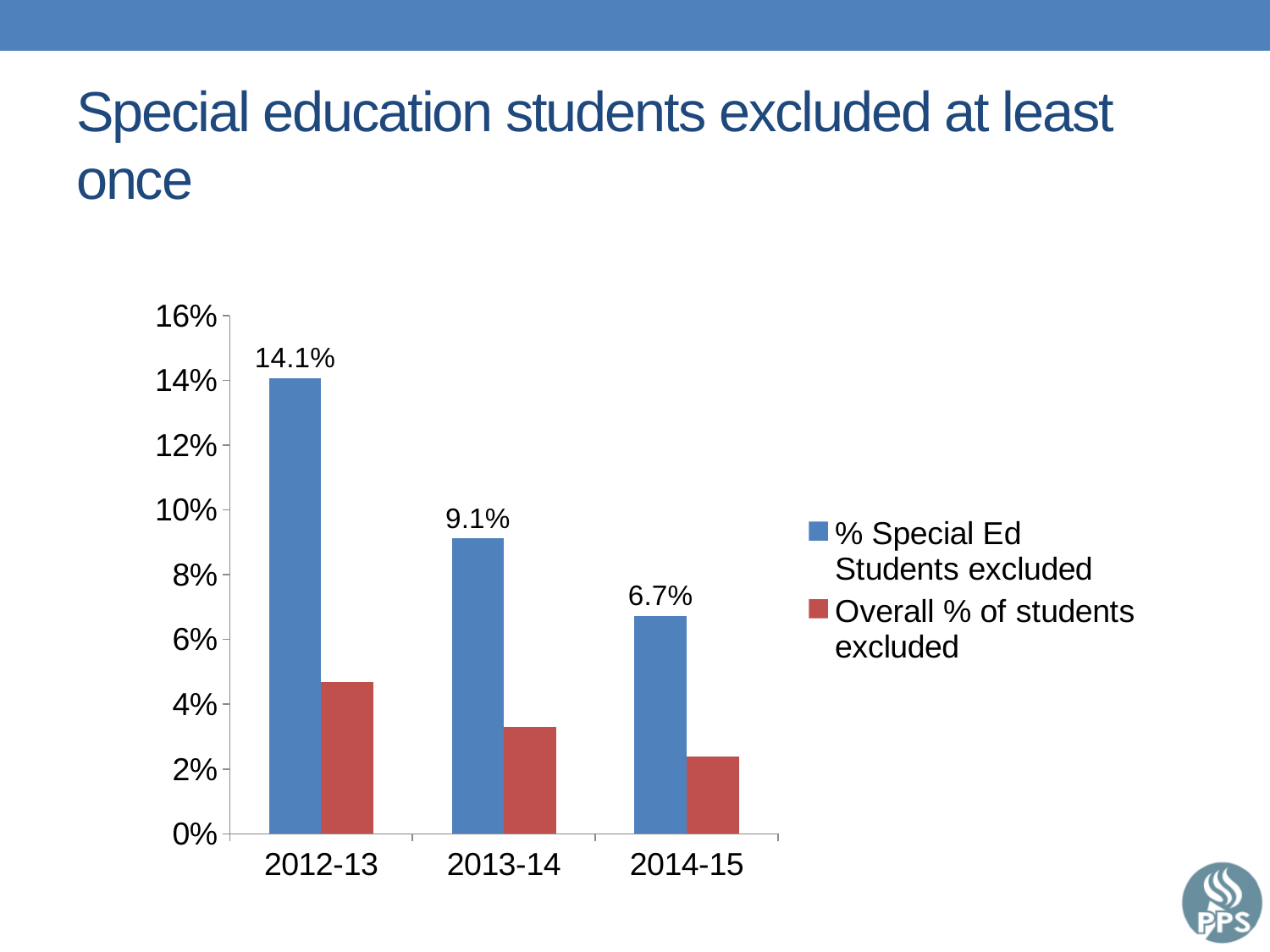
What kind of chart is shown on the slide? Bar chart Which year has the lowest value for % Special Ed Students excluded? 2014-15 What is the value for % Special Ed Students excluded in 2012-13? 14.1% What is the difference between the % Special Ed Students excluded in 2012-13 and 2014-15? 7.4% How many series does the legend list? 2 Is the value for Overall % of students excluded in 2014-15 greater or less than 4%? less Which is larger: % Special Ed Students excluded in 2013-14 or Overall % of students excluded in 2013-14? % Special Ed Students excluded What is the value for % Special Ed Students excluded in 2013-14? 9.1% Which year has the highest value for % Special Ed Students excluded? 2012-13 How many years are shown on the x axis? 3 Is the value for Overall % of students excluded in 2012-13 greater or less than 4%? greater What is the value for % Special Ed Students excluded in 2014-15? 6.7%